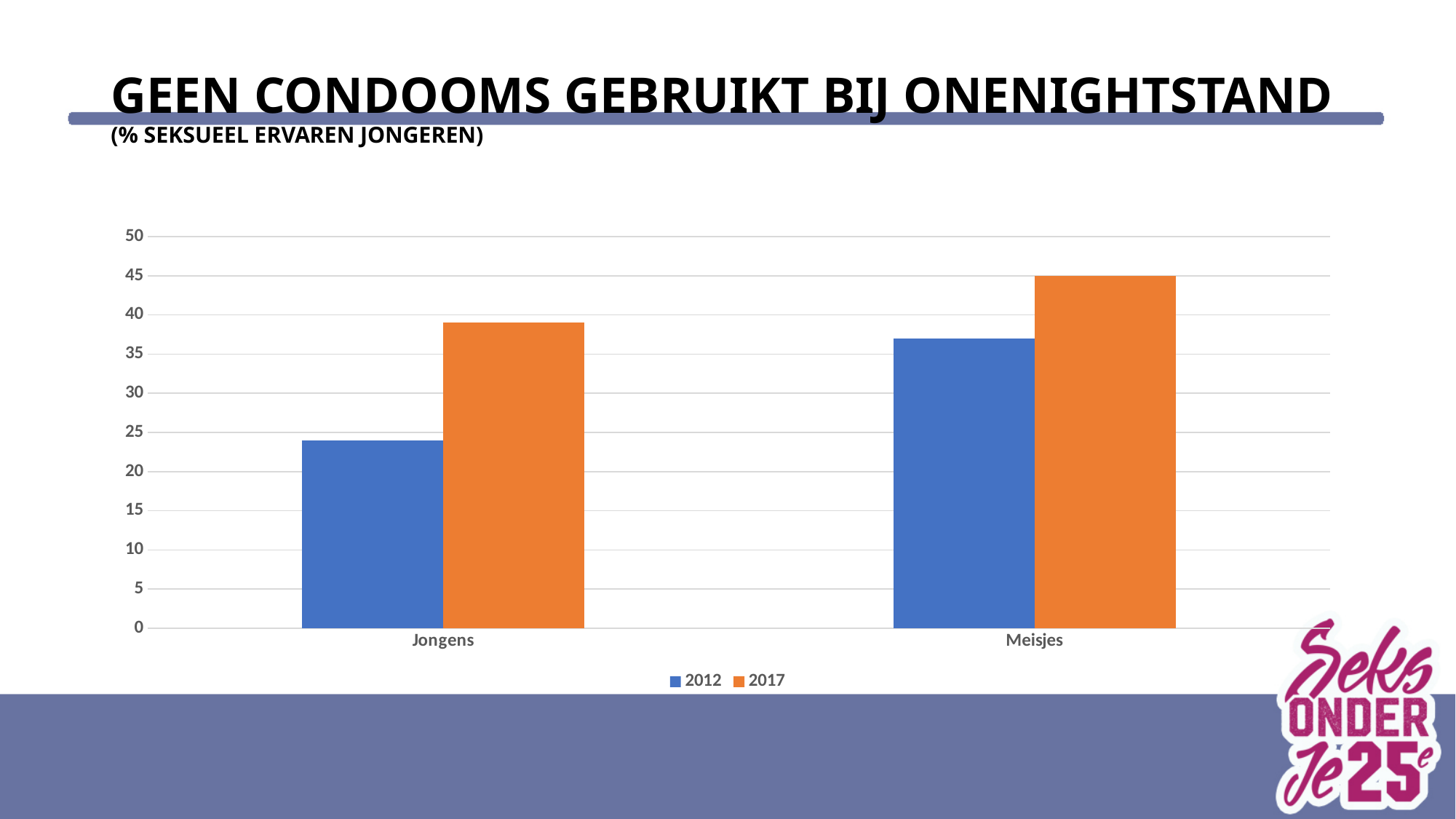
Is the 2012 value for Jongens greater or less than 30? less Which category has the highest 2017 value? Meisjes What kind of chart is shown on the slide? bar chart Which series does the legend list first? 2012 What is the title of the chart? GEEN CONDOOMS GEBRUIKT BIJ ONENIGHTSTAND Is the 2017 value for Meisjes greater or less than 40? greater How many categories are shown on the x axis? 2 Which category has the lowest 2012 value? Jongens Is the 2012 value for Meisjes greater or less than 30? greater For Jongens, which is larger: the 2012 value or the 2017 value? 2017 How many series does the legend list? 2